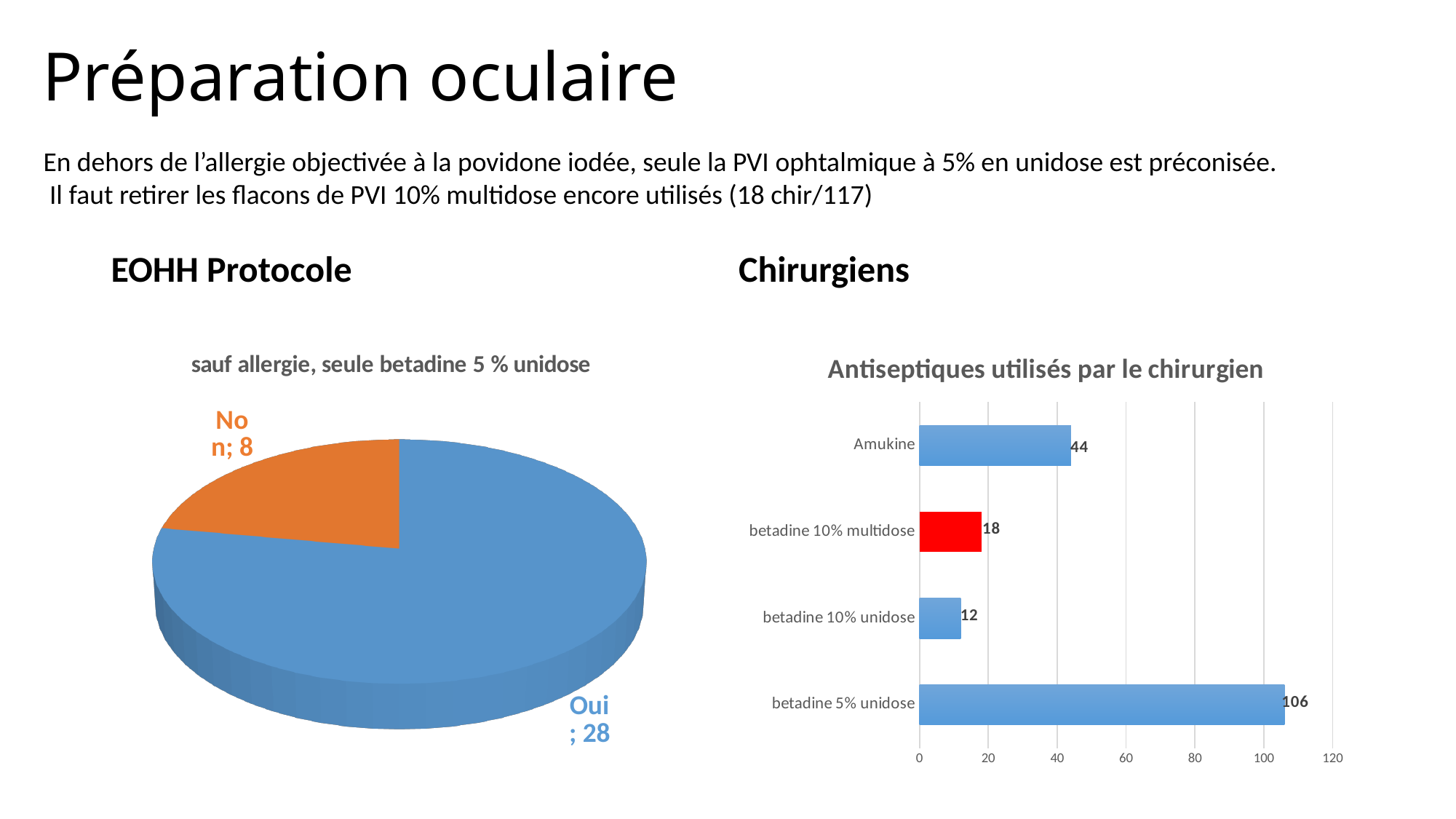
In the chart titled 'Antiseptiques utilisés par le chirurgien', what is the value for 'Amukine'? 44 In the chart titled 'Antiseptiques utilisés par le chirurgien', which bar is coloured red? betadine 10% multidose In the chart titled 'Antiseptiques utilisés par le chirurgien', what is the difference between 'betadine 5% unidose' and 'Amukine'? 62 In the pie chart titled 'sauf allergie, seule betadine 5 % unidose', what is the value for 'Non'? 8 In the chart titled 'Antiseptiques utilisés par le chirurgien', what kind of chart is shown? Bar chart In the pie chart titled 'sauf allergie, seule betadine 5 % unidose', what is the difference between 'Oui' and 'Non'? 20 In the chart titled 'Antiseptiques utilisés par le chirurgien', what is the value for 'betadine 10% multidose'? 18 In the chart titled 'Antiseptiques utilisés par le chirurgien', which category has the highest value? betadine 5% unidose In the pie chart titled 'sauf allergie, seule betadine 5 % unidose', how many slices are there? 2 In the pie chart titled 'sauf allergie, seule betadine 5 % unidose', what is the value for 'Oui'? 28 In the chart titled 'Antiseptiques utilisés par le chirurgien', which category has the lowest value? betadine 10% unidose In the pie chart titled 'sauf allergie, seule betadine 5 % unidose', what colour is the 'Non' slice? Orange